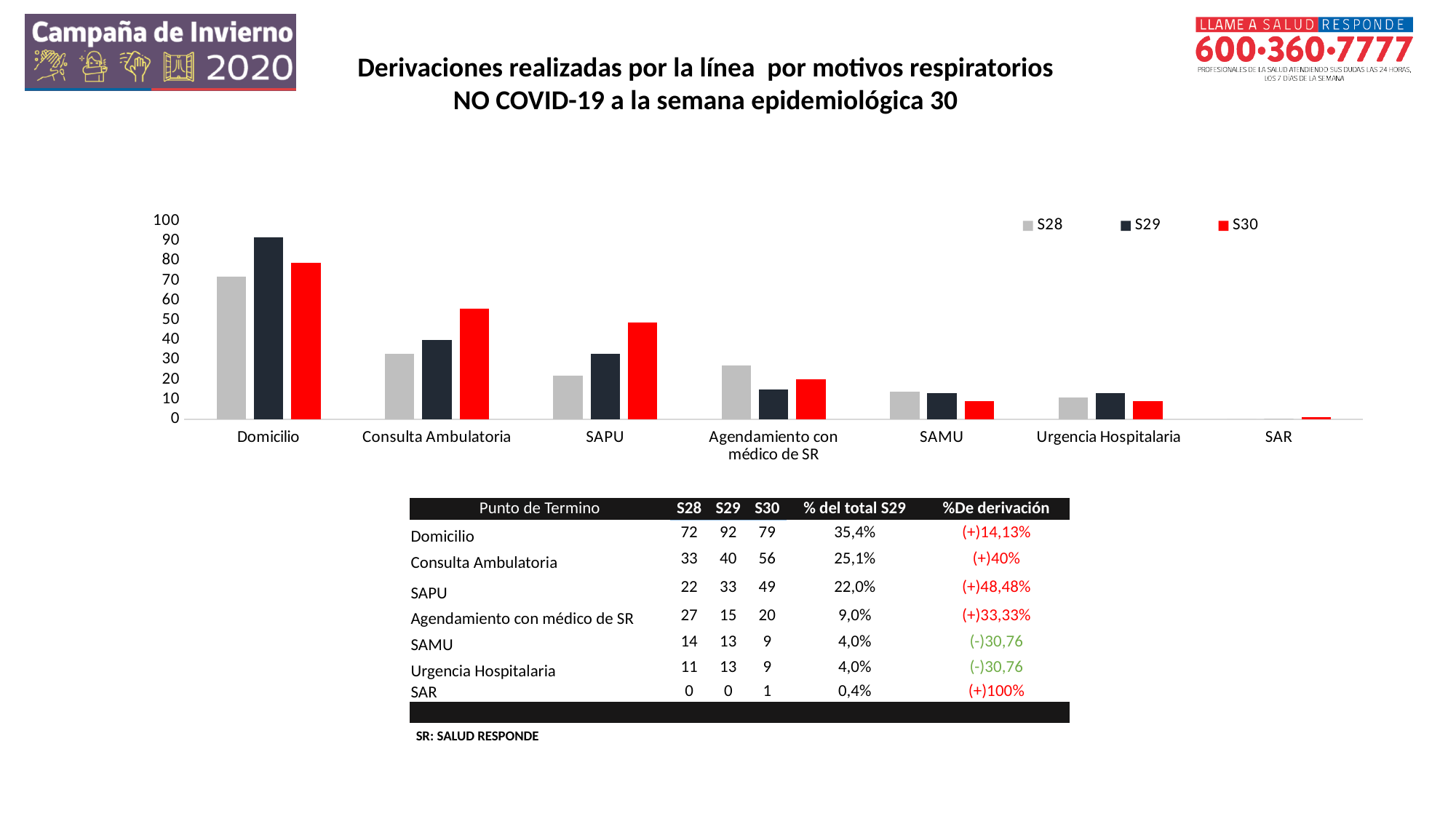
Which category has the highest S29 value? Domicilio Is the S30 value for SAMU greater or less than 20? less Is the S29 value for Domicilio greater or less than 80? greater What is the S30 value for Consulta Ambulatoria? 56 Which is larger for SAPU, the S29 value or the S30 value? S30 What is the S28 value for SAPU? 22 How many series does the chart legend list? 3 How many categories are shown on the x axis of the chart? 7 What kind of chart is shown on the slide? bar chart What is the difference between the S30 and S28 values for Consulta Ambulatoria? 23 Which series is shown in red in the chart? S30 Which category has the lowest S30 value? SAR